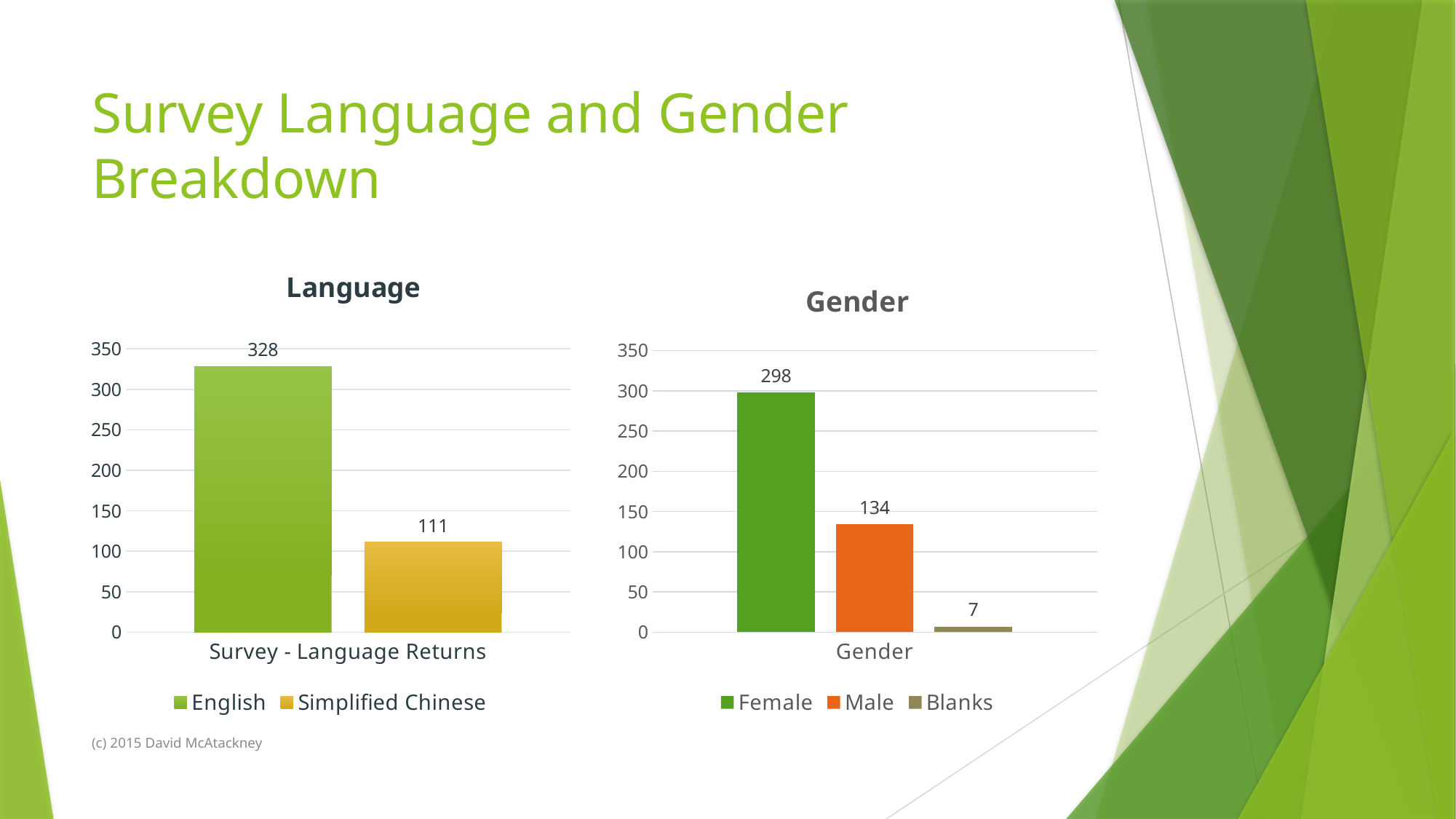
In the Gender chart, which series has the lowest value? Blanks In the Language chart, what is the difference between the English and Simplified Chinese values? 217 In the Gender chart, what is the value for Blanks? 7 In the Language chart, what is the value for English? 328 In the Gender chart, what is the value for Female? 298 In the Gender chart, which series has the highest value? Female In the Gender chart, how many series does the legend list? 3 In the Gender chart, what is the value for Male? 134 In the Language chart, what is the value for Simplified Chinese? 111 In the Gender chart, what is the difference between the Female and Male values? 164 What kind of chart is the Gender chart? Bar chart In the Language chart, how many series does the legend list? 2